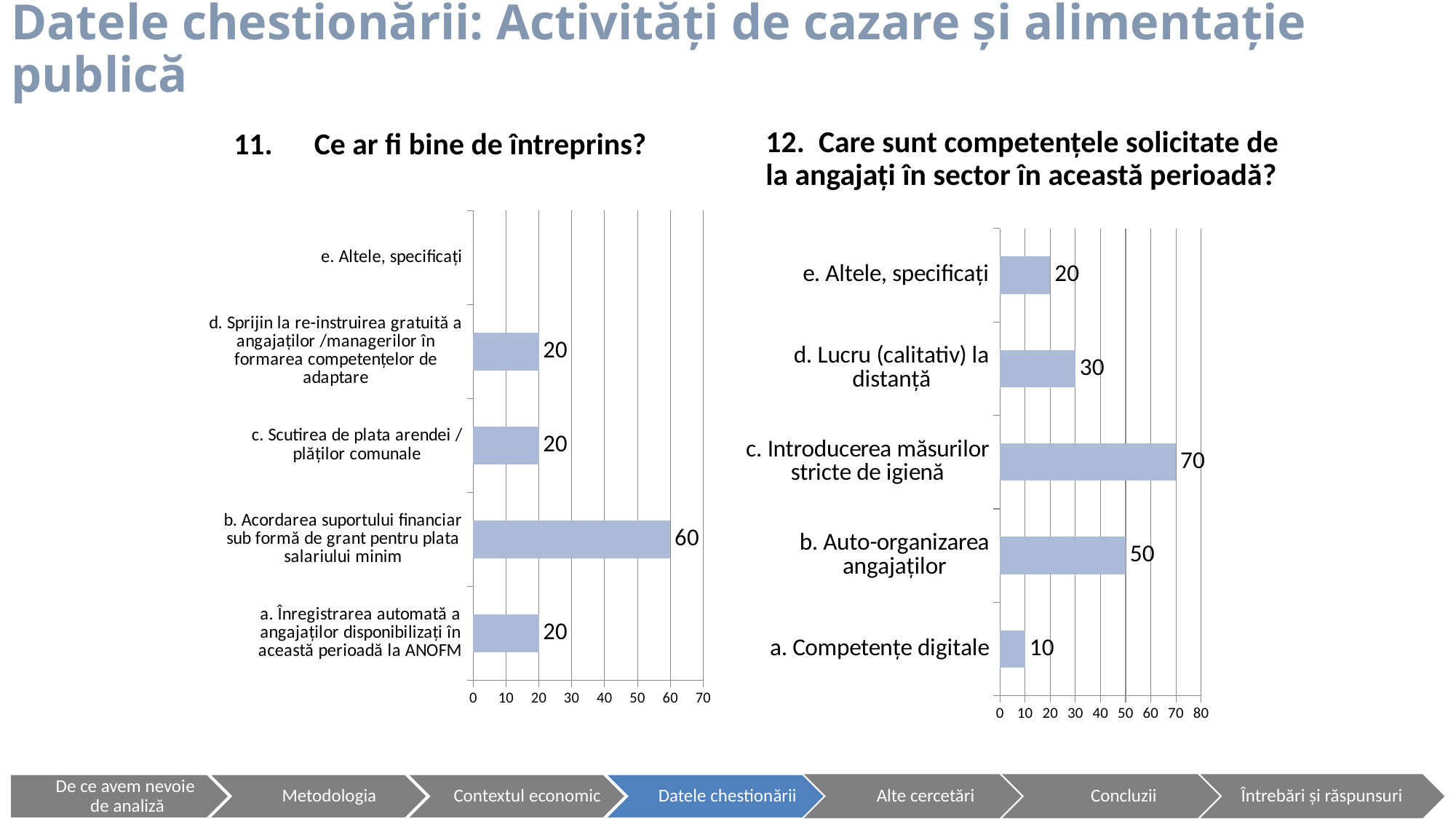
In the chart '11. Ce ar fi bine de întreprins?', what is the difference between the value for 'b. Acordarea suportului financiar sub formă de grant pentru plata salariului minim' and the value for 'c. Scutirea de plata arendei / plăților comunale'? 40 In the chart '12. Care sunt competențele solicitate de la angajați în sector în această perioadă?', what is the value for 'c. Introducerea măsurilor stricte de igienă'? 70 In the chart '12. Care sunt competențele solicitate de la angajați în sector în această perioadă?', which is larger: the value for 'b. Auto-organizarea angajaților' or the value for 'e. Altele, specificați'? b. Auto-organizarea angajaților In the chart '12. Care sunt competențele solicitate de la angajați în sector în această perioadă?', how many categories are shown? 5 In the chart '12. Care sunt competențele solicitate de la angajați în sector în această perioadă?', what is the value for 'd. Lucru (calitativ) la distanță'? 30 In the chart '12. Care sunt competențele solicitate de la angajați în sector în această perioadă?', what is the difference between the value for 'c. Introducerea măsurilor stricte de igienă' and the value for 'a. Competențe digitale'? 60 In the chart '11. Ce ar fi bine de întreprins?', which category has the highest value? b. Acordarea suportului financiar sub formă de grant pentru plata salariului minim In the chart '11. Ce ar fi bine de întreprins?', how many categories are shown on the vertical axis? 5 What kind of chart is '11. Ce ar fi bine de întreprins?'? bar chart In the chart '12. Care sunt competențele solicitate de la angajați în sector în această perioadă?', which category has the lowest value? a. Competențe digitale In the chart '12. Care sunt competențele solicitate de la angajați în sector în această perioadă?', what is the highest value shown on the horizontal axis? 80 In the chart '11. Ce ar fi bine de întreprins?', what is the value for 'b. Acordarea suportului financiar sub formă de grant pentru plata salariului minim'? 60